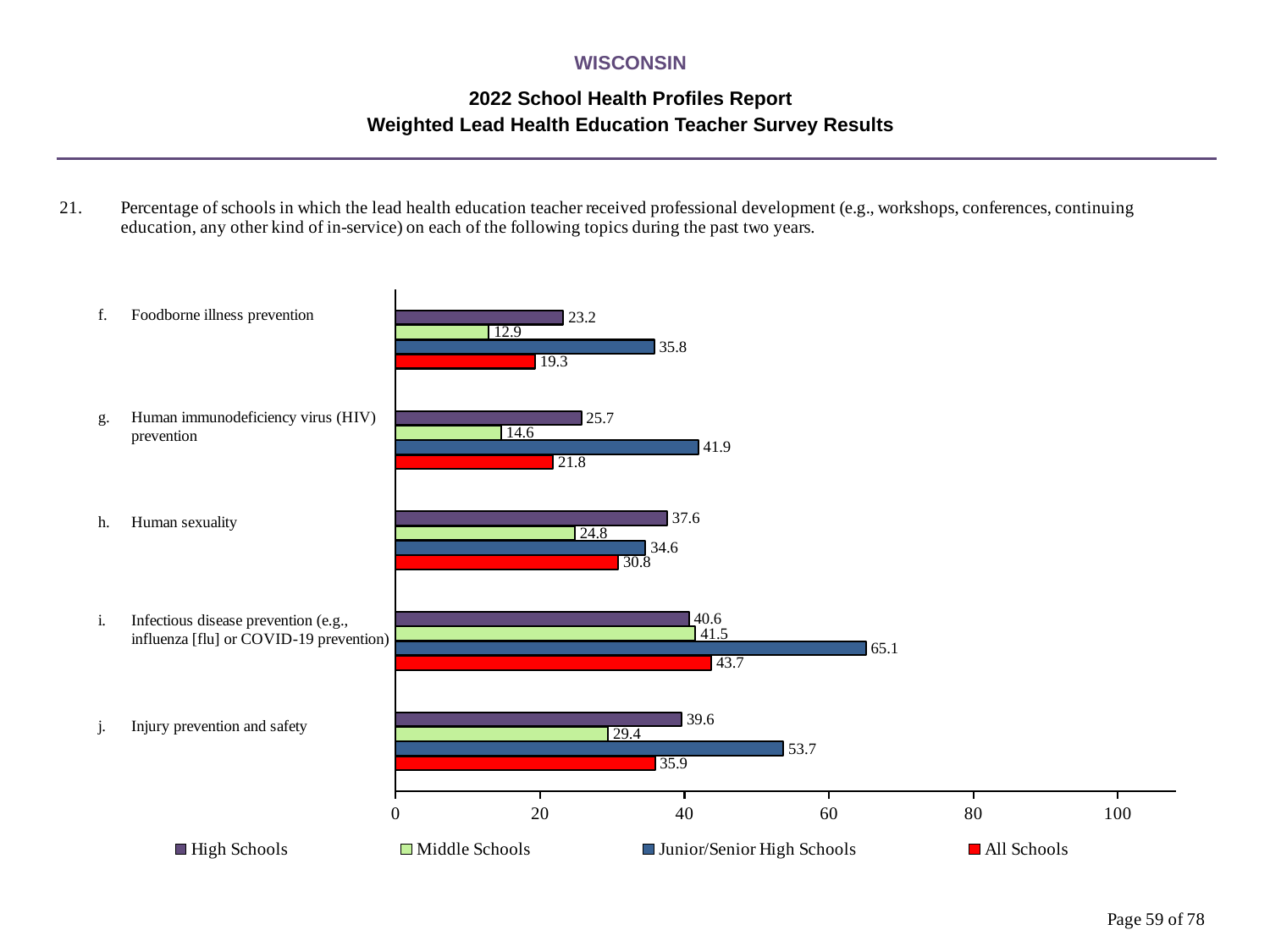
Which topic has the lowest value for Middle Schools? Foodborne illness prevention What is the value for All Schools for Human sexuality? 30.8 How many topics are shown in the chart? 5 Which topic has the highest value for High Schools? Infectious disease prevention (e.g., influenza [flu] or COVID-19 prevention) Which series is shown in red in the legend? All Schools Is the All Schools value for Human immunodeficiency virus (HIV) prevention greater or less than 20? greater For Human sexuality, which is larger: the High Schools value or the Junior/Senior High Schools value? High Schools What is the value for Junior/Senior High Schools for Infectious disease prevention (e.g., influenza [flu] or COVID-19 prevention)? 65.1 How many series does the legend list? 4 What kind of chart is shown on the slide? Bar chart What is the difference between the Junior/Senior High Schools and Middle Schools values for Injury prevention and safety? 24.3 What is the value for Middle Schools for Foodborne illness prevention? 12.9